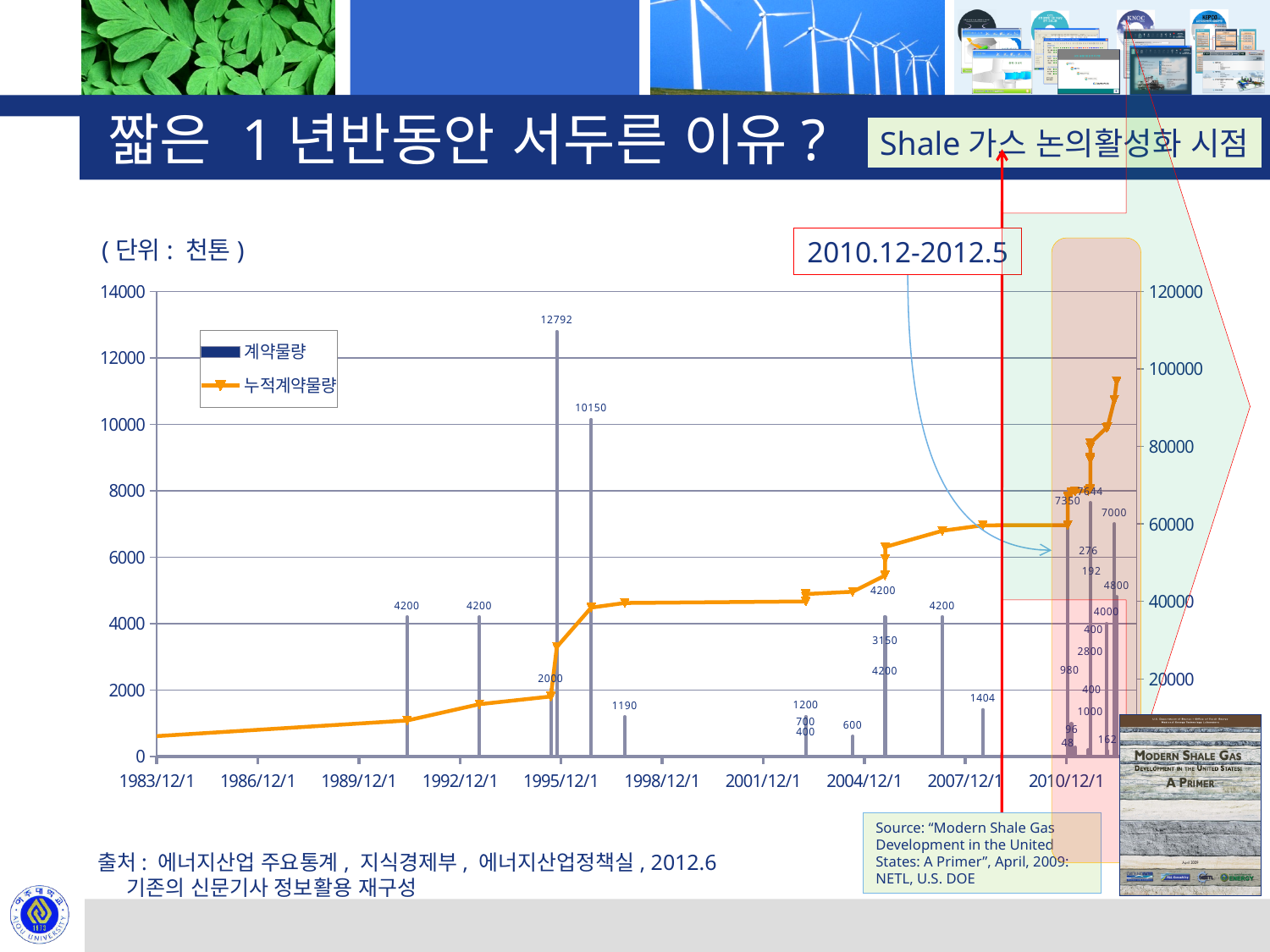
Is the bar labelled 10150 greater or less than 10000 on the left axis? greater Does the cumulative line (누적계약물량) rise or fall from left to right along the x axis? Rises What unit is stated for the chart values? 천톤 Which is larger, the bar labelled 7644 or the bar labelled 7000? 7644 What is the maximum value shown on the left vertical axis? 14000 What is the highest labelled bar value (계약물량) in the chart? 12792 How many series does the chart legend list? 2 What are the two series named in the chart legend? 계약물량 and 누적계약물량 What is the lowest labelled bar value (계약물량) in the chart? 48 What kind of chart is shown on the slide? A combined bar and line chart What is the difference between the bars labelled 7644 and 7350? 294 What is the difference between the two tallest labelled bars, 12792 and 10150? 2642